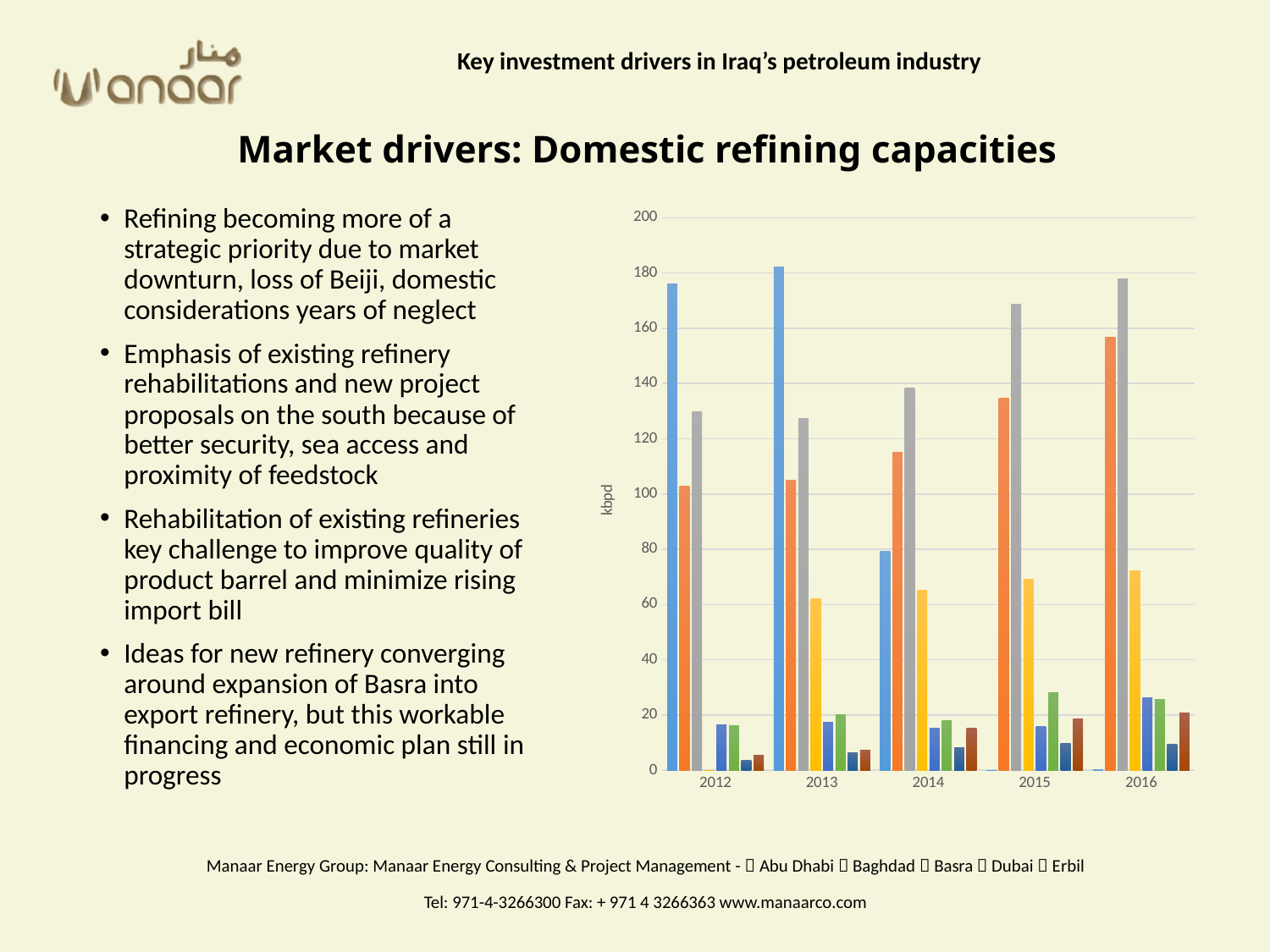
Do the blue bars rise or fall from 2013 to 2016? fall How many years are shown along the x axis of the chart? 5 Which year is the first category on the x axis of the chart? 2012 What is the label on the vertical axis of the chart? kbpd Is the value of the tallest blue bar in 2013 greater or less than 160? greater Is the value of the orange bar in 2012 greater or less than 120? less Do the orange bars rise or fall from 2012 to 2016? rise Is the value of the grey bar in 2016 greater or less than 160? greater What kind of chart is shown on the slide? bar chart What is the highest value shown on the vertical axis of the chart? 200 Which year is the last category on the x axis of the chart? 2016